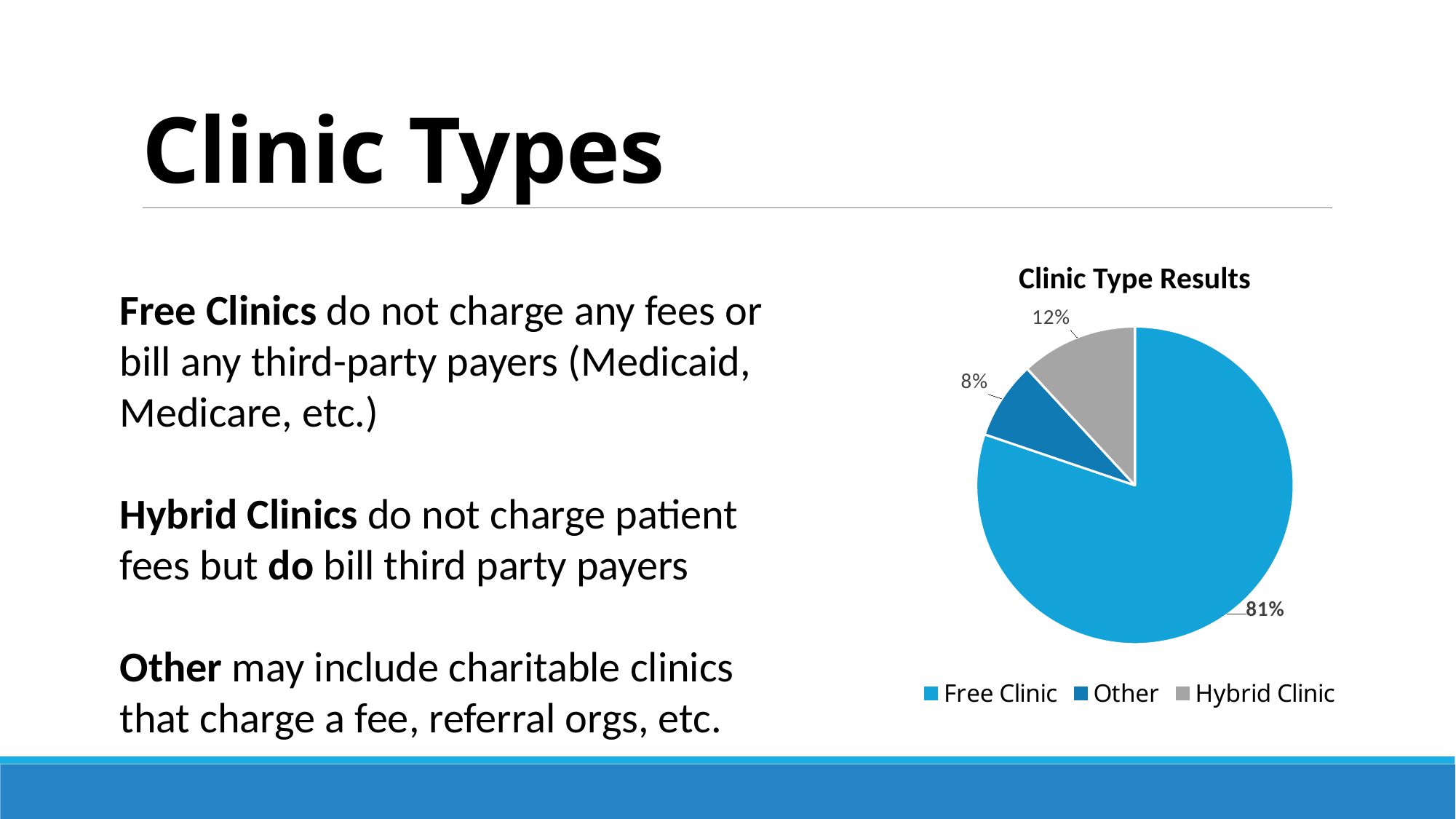
What percentage of the pie is Free Clinic? 81% How many entries does the legend list? 3 Which slice is larger, Hybrid Clinic or Other? Hybrid Clinic Which clinic type has the smallest share of the pie? Other What is the title of the chart? Clinic Type Results What type of chart is shown on the slide? Pie chart What colour is the Hybrid Clinic slice? Gray What is the difference in percentage points between the Free Clinic and Hybrid Clinic slices? 69 What percentage of the pie is Other? 8% How many slices does the pie chart have? 3 Which clinic type has the largest share of the pie? Free Clinic What percentage of the pie is Hybrid Clinic? 12%